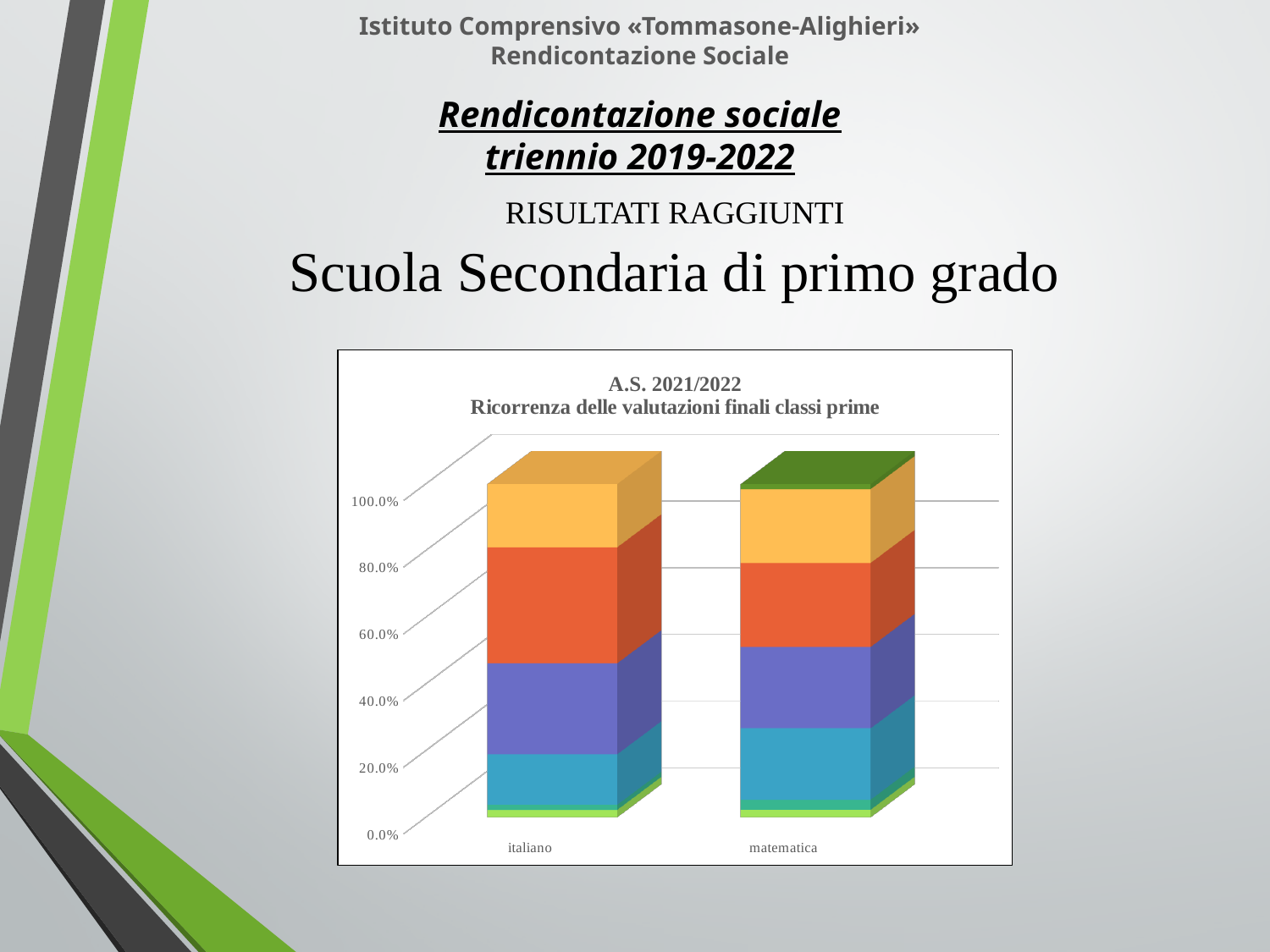
What is the lowest value shown on the y axis of the chart? 0.0% What kind of chart is shown on the slide? stacked bar chart Which school year does the chart refer to? A.S. 2021/2022 Which category's bar has a dark green segment at the top? matematica What is the highest value shown on the y axis of the chart? 100.0% What is the title of the chart? A.S. 2021/2022 Ricorrenza delle valutazioni finali classi prime What are the two categories shown on the x axis of the chart? italiano and matematica How many categories are shown on the x axis of the chart? 2